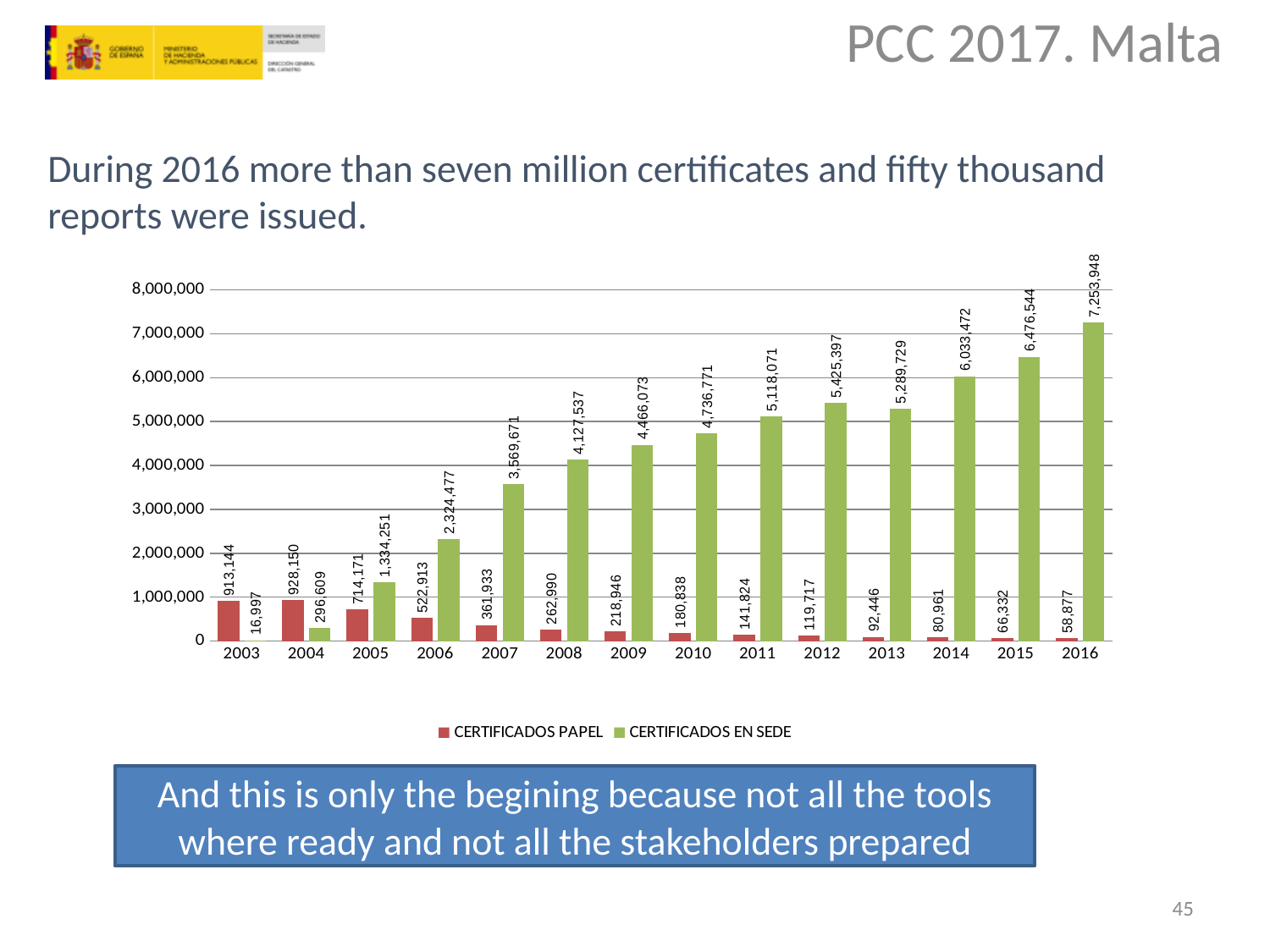
In which year is CERTIFICADOS EN SEDE lowest? 2003 In which year is CERTIFICADOS EN SEDE highest? 2016 In which year is CERTIFICADOS PAPEL lowest? 2016 What is the value of CERTIFICADOS EN SEDE for 2010? 4,736,771 What is the value of CERTIFICADOS EN SEDE for 2016? 7,253,948 What is the difference between CERTIFICADOS EN SEDE in 2016 and in 2015? 777,404 How many years are shown on the x axis? 14 What kind of chart is shown on the slide? Bar chart How many series does the legend list? 2 Which is larger in 2004: CERTIFICADOS PAPEL or CERTIFICADOS EN SEDE? CERTIFICADOS PAPEL Is the value of CERTIFICADOS EN SEDE for 2013 greater or less than 5,000,000? greater What is the value of CERTIFICADOS PAPEL for 2003? 913,144